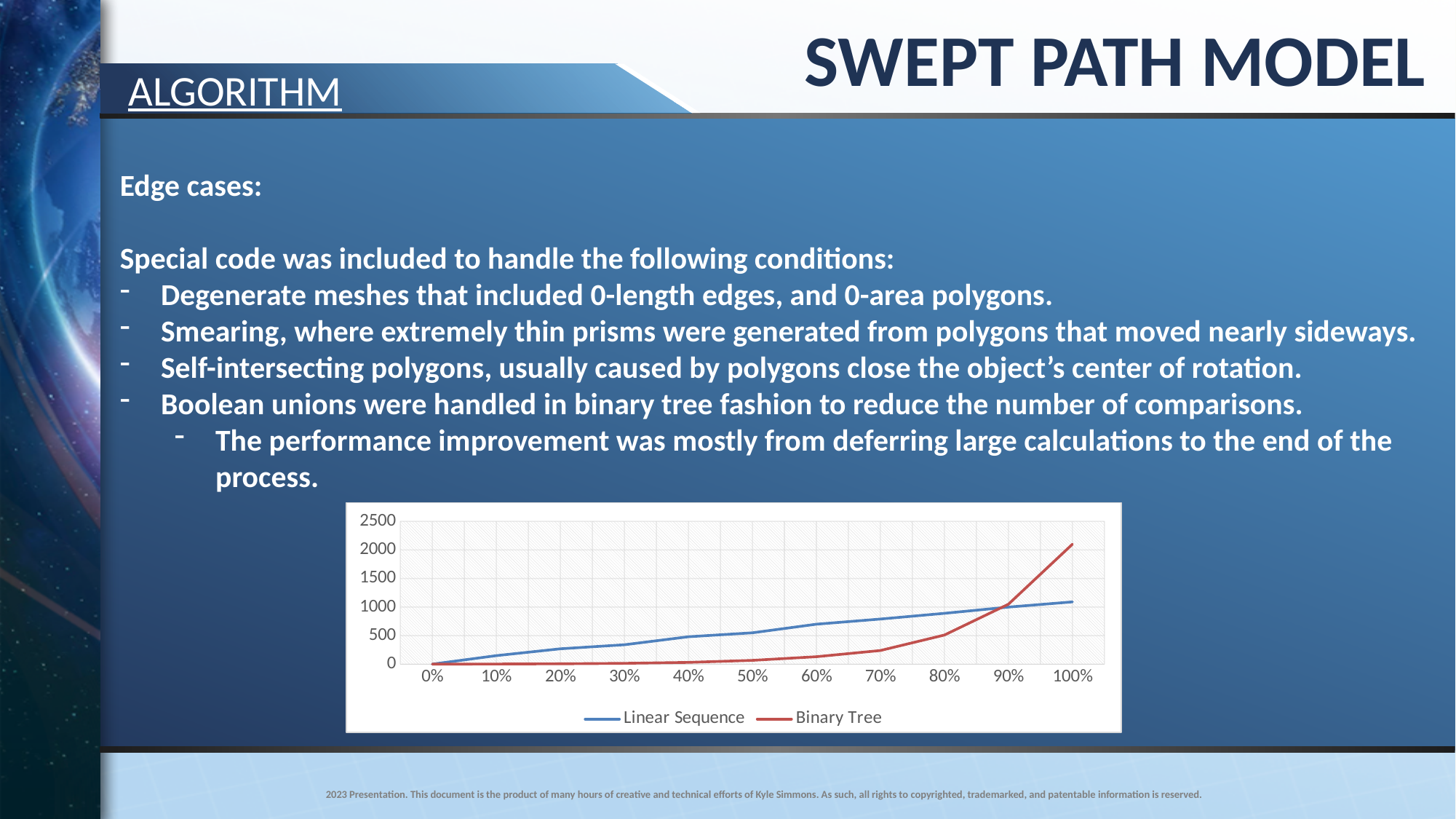
How many series does the chart's legend list? 2 At 100%, which series has the higher value, Linear Sequence or Binary Tree? Binary Tree Is the value of the Binary Tree series at 60% greater or less than 500? less Is the value of the Linear Sequence series at 30% greater or less than 500? less How many points are marked along the x axis of the chart? 11 At 50%, which series has the higher value, Linear Sequence or Binary Tree? Linear Sequence Does the Binary Tree series rise or fall as the x axis goes from 0% to 100%? Rise Which series is drawn in red in the chart? Binary Tree Does the Linear Sequence series rise or fall as the x axis goes from 0% to 100%? Rise Is the value of the Binary Tree series at 100% greater or less than 1500? greater What kind of chart is shown on the slide? Line chart What are the names of the two series in the chart's legend? Linear Sequence and Binary Tree